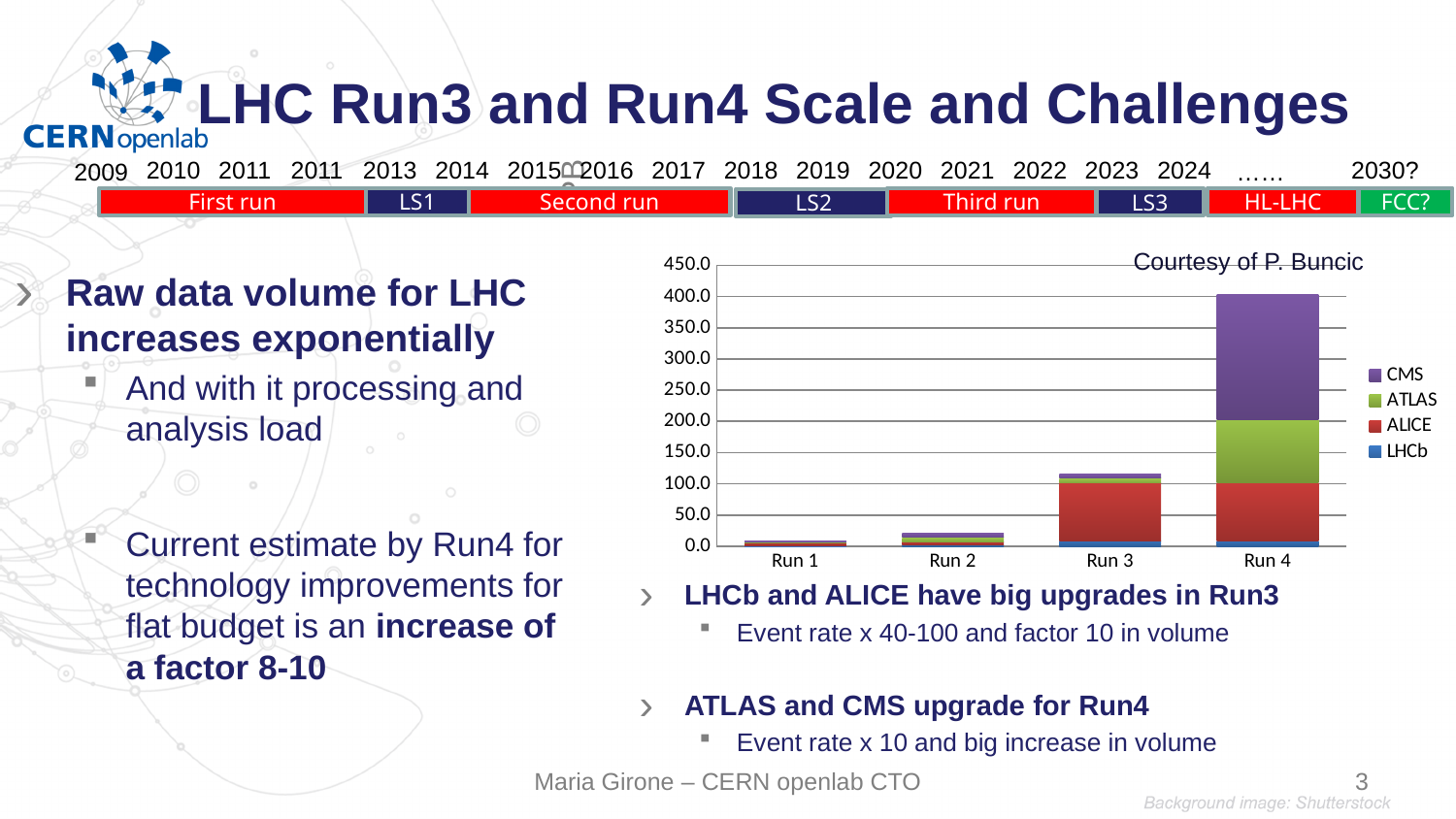
Do the stacked bar totals rise or fall from Run 1 to Run 4? rise Which run has the shortest stacked bar in the chart? Run 1 Is the total value for Run 4 greater or less than 350.0? greater What kind of chart is shown on the slide? stacked bar chart Which series is shown in purple in the chart's legend? CMS Is the total value for Run 3 greater or less than 100.0? greater Which run has the tallest stacked bar in the chart? Run 4 Is the total value for Run 2 greater or less than 50.0? less How many series does the chart's legend list? 4 Which is larger, the total bar for Run 3 or the total bar for Run 2? Run 3 How many categories (runs) are shown on the x axis of the chart? 4 According to the note above the chart, who is the chart courtesy of? P. Buncic